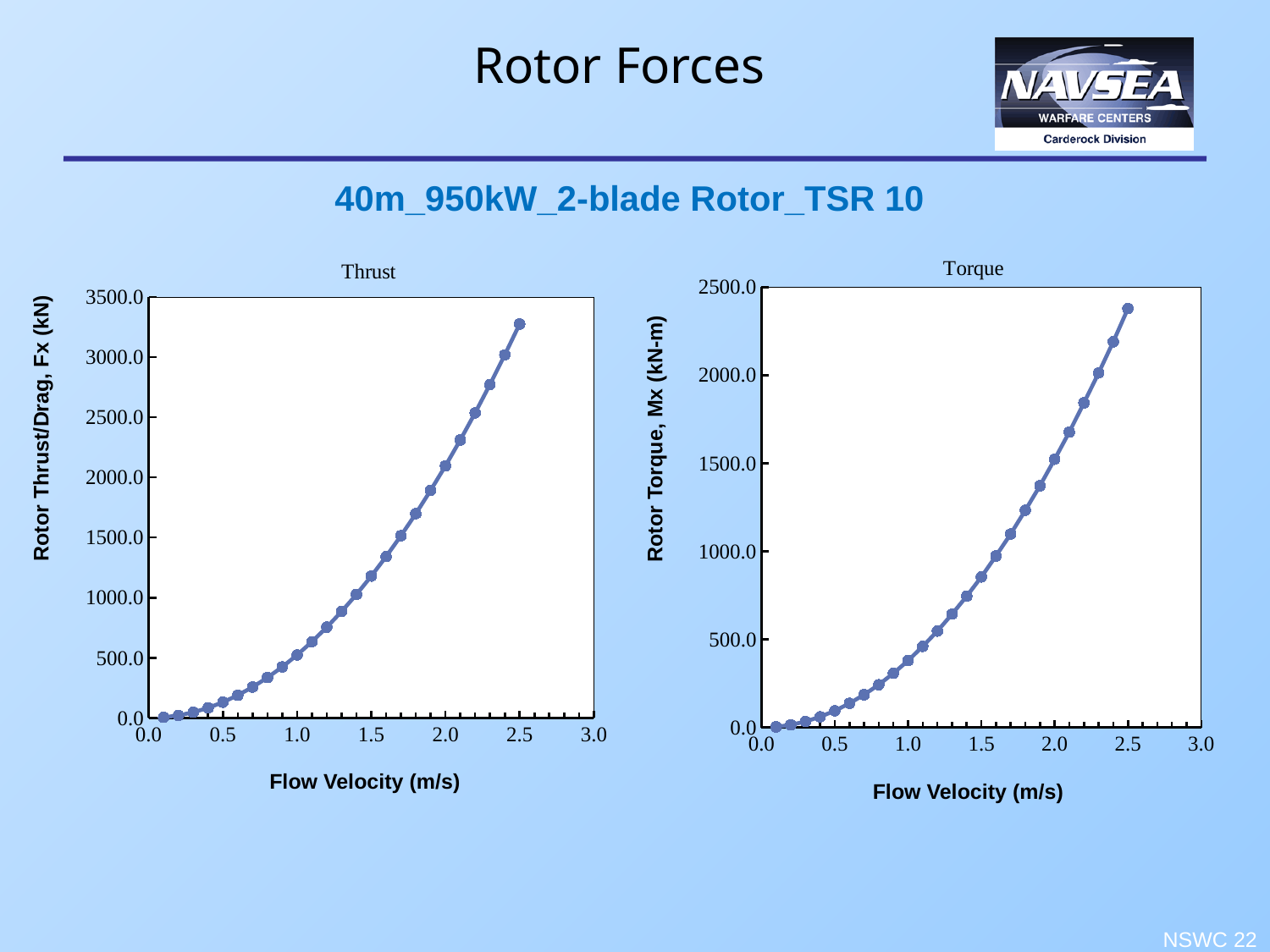
In the Torque chart, is the value at a flow velocity of 1.0 m/s greater or less than 500.0? less In the Thrust chart, is the value at a flow velocity of 2.5 m/s greater or less than 3000.0? greater In the Torque chart, is the value at a flow velocity of 1.5 m/s greater or less than 1000.0? less In the Thrust chart, at which flow velocity is the thrust highest? 2.5 What is the x-axis title of the Thrust chart? Flow Velocity (m/s) What type of chart is the Thrust chart? line chart In the Thrust chart, do the values rise or fall as flow velocity increases? rise What is the y-axis title of the Torque chart? Rotor Torque, Mx (kN-m) In the Torque chart, do the values rise or fall as flow velocity increases? rise